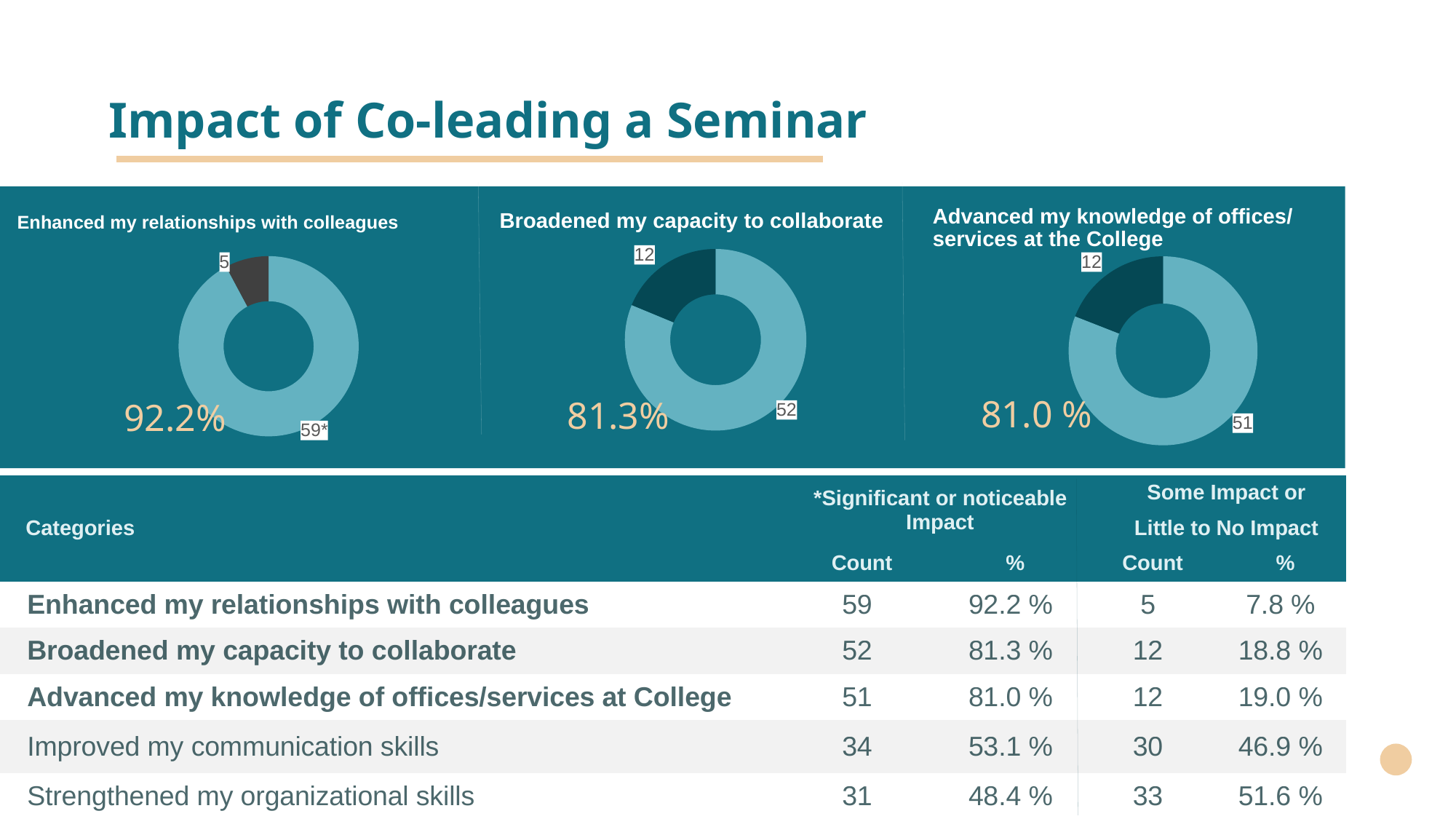
What type of chart is used for "Enhanced my relationships with colleagues"? Donut (pie) chart How many slices does the "Enhanced my relationships with colleagues" chart have? 2 In the "Advanced my knowledge of offices/services at the College" chart, what is the total of the two slice values? 63 What percentage is displayed on the "Advanced my knowledge of offices/services at the College" chart? 81.0 % In the "Advanced my knowledge of offices/services at the College" chart, what is the value of the larger slice? 51 In the "Enhanced my relationships with colleagues" chart, what is the value of the smaller slice? 5 In the "Enhanced my relationships with colleagues" chart, what is the value of the larger slice? 59* In the "Broadened my capacity to collaborate" chart, what is the value of the larger slice? 52 What percentage is displayed on the "Enhanced my relationships with colleagues" chart? 92.2% In the "Broadened my capacity to collaborate" chart, what is the value of the smaller slice? 12 In the "Broadened my capacity to collaborate" chart, what is the difference between the two slice values? 40 What percentage is displayed on the "Broadened my capacity to collaborate" chart? 81.3%